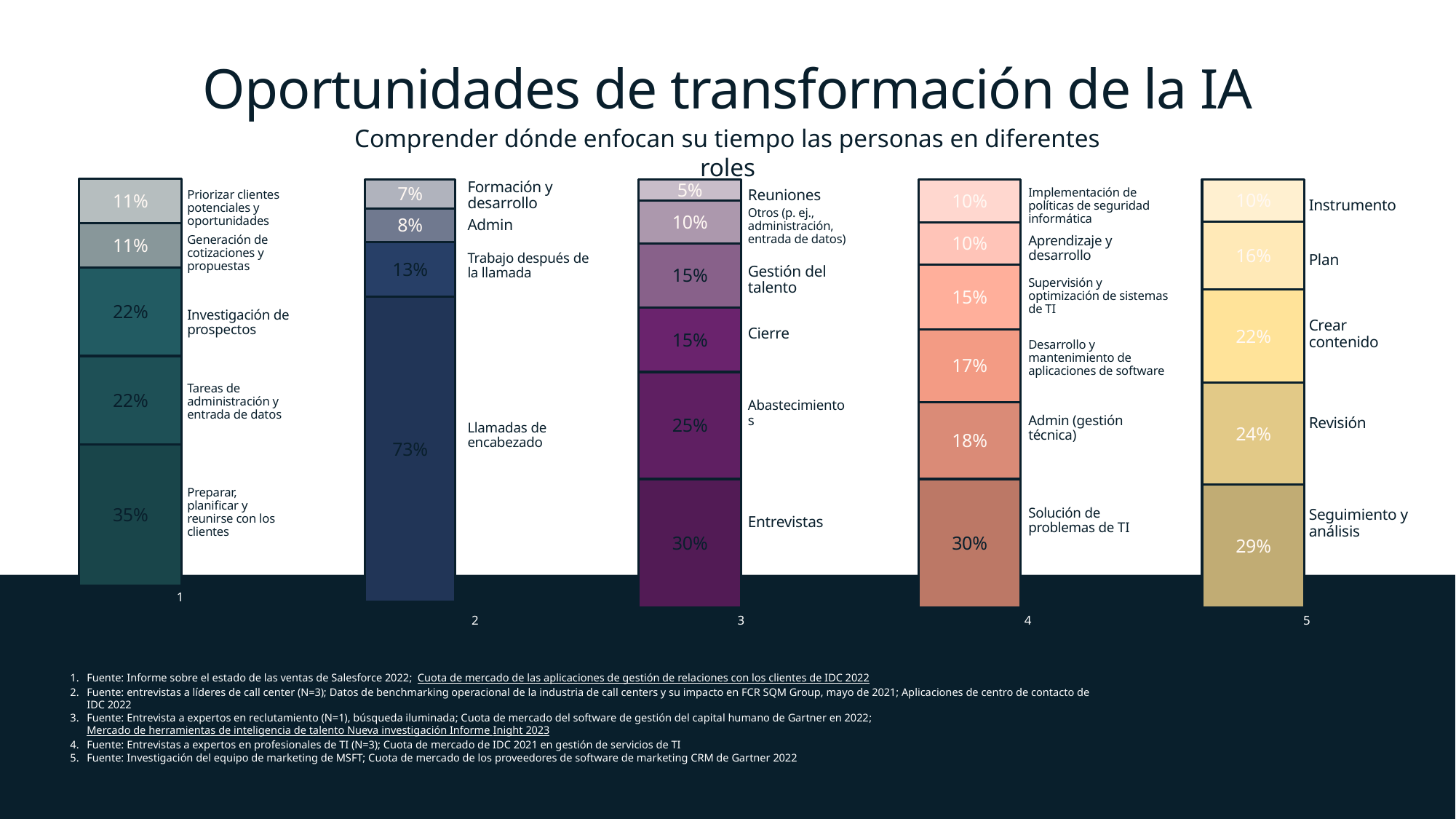
In the fourth chart from the left (bar 4), what percentage is shown for 'Admin (gestión técnica)'? 18% What kind of chart is used on this slide? Stacked bar chart In the rightmost chart (bar 5), which segment has the largest share? Seguimiento y análisis What is the title of the slide? Oportunidades de transformación de la IA In the middle chart (bar 3), what is the total of all the segment values? 100% In the middle chart (bar 3), what percentage is shown for 'Entrevistas'? 30% In the second chart from the left (bar 2), what is the difference between 'Llamadas de encabezado' and 'Trabajo después de la llamada'? 60% In the rightmost chart (bar 5), which is larger: 'Revisión' or 'Plan'? Revisión In the second chart from the left (bar 2), what percentage is shown for 'Llamadas de encabezado'? 73% In the leftmost chart (bar 1), what percentage is shown for 'Preparar, planificar y reunirse con los clientes'? 35% In the middle chart (bar 3), which segment has the smallest share? Reuniones How many segments does the fourth chart from the left (bar 4) contain? 6